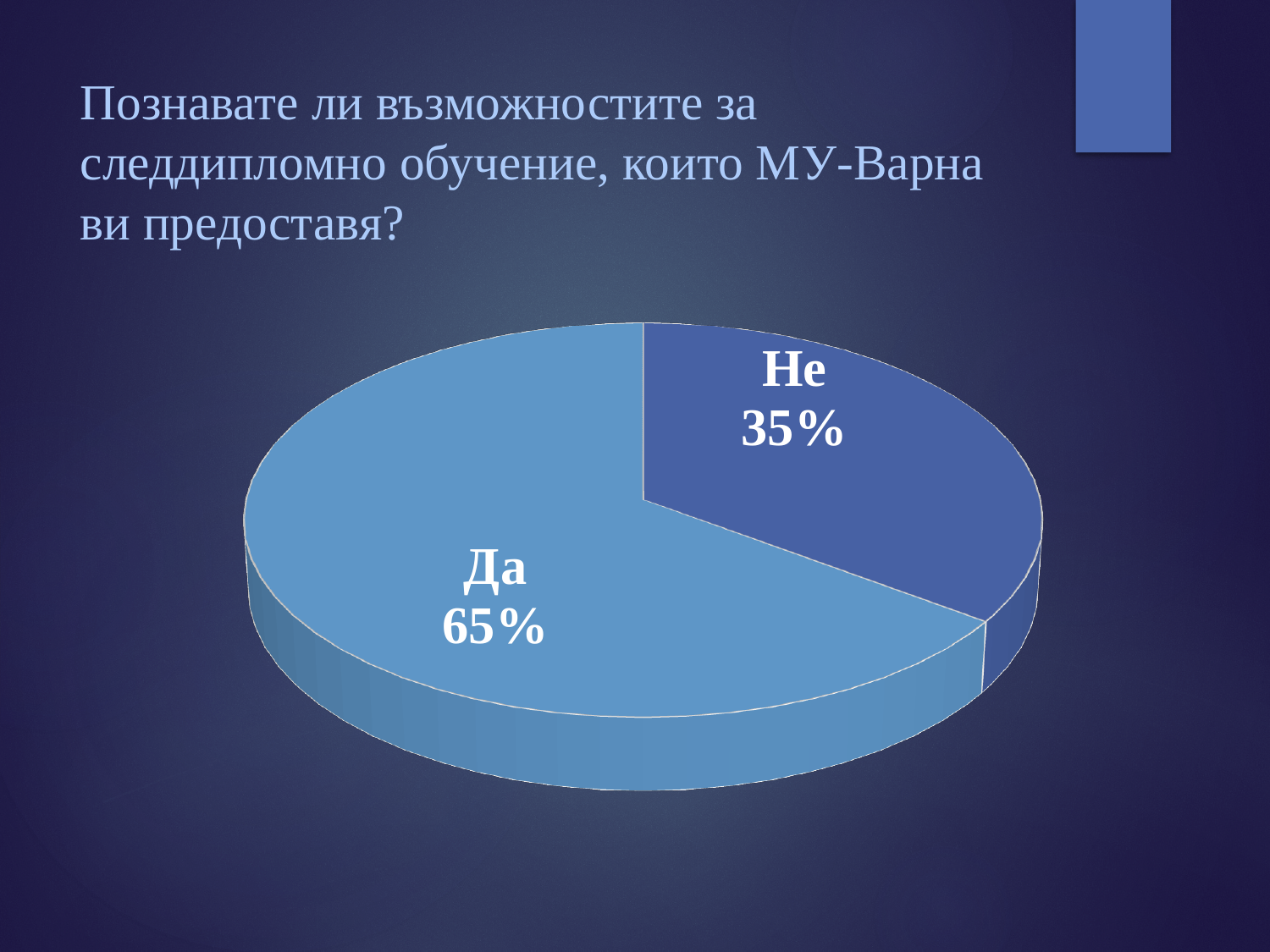
What is the total of the two slices shown in the pie chart? 100% Which answer has the smallest share of the pie? Не What percentage of respondents answered "Не"? 35% What question does the slide title ask about the chart? Познавате ли възможностите за следдипломно обучение, които МУ-Варна ви предоставя? How many slices does the pie chart have? 2 Which slice is shown in the darker blue colour? Не What kind of chart is shown on the slide? Pie chart What share of the pie does the "Не" slice represent? 35% What percentage of respondents answered "Да"? 65% Which answer has the largest share of the pie? Да What is the difference in percentage points between the "Да" and "Не" slices? 30 Which is larger, the share for "Да" or the share for "Не"? Да